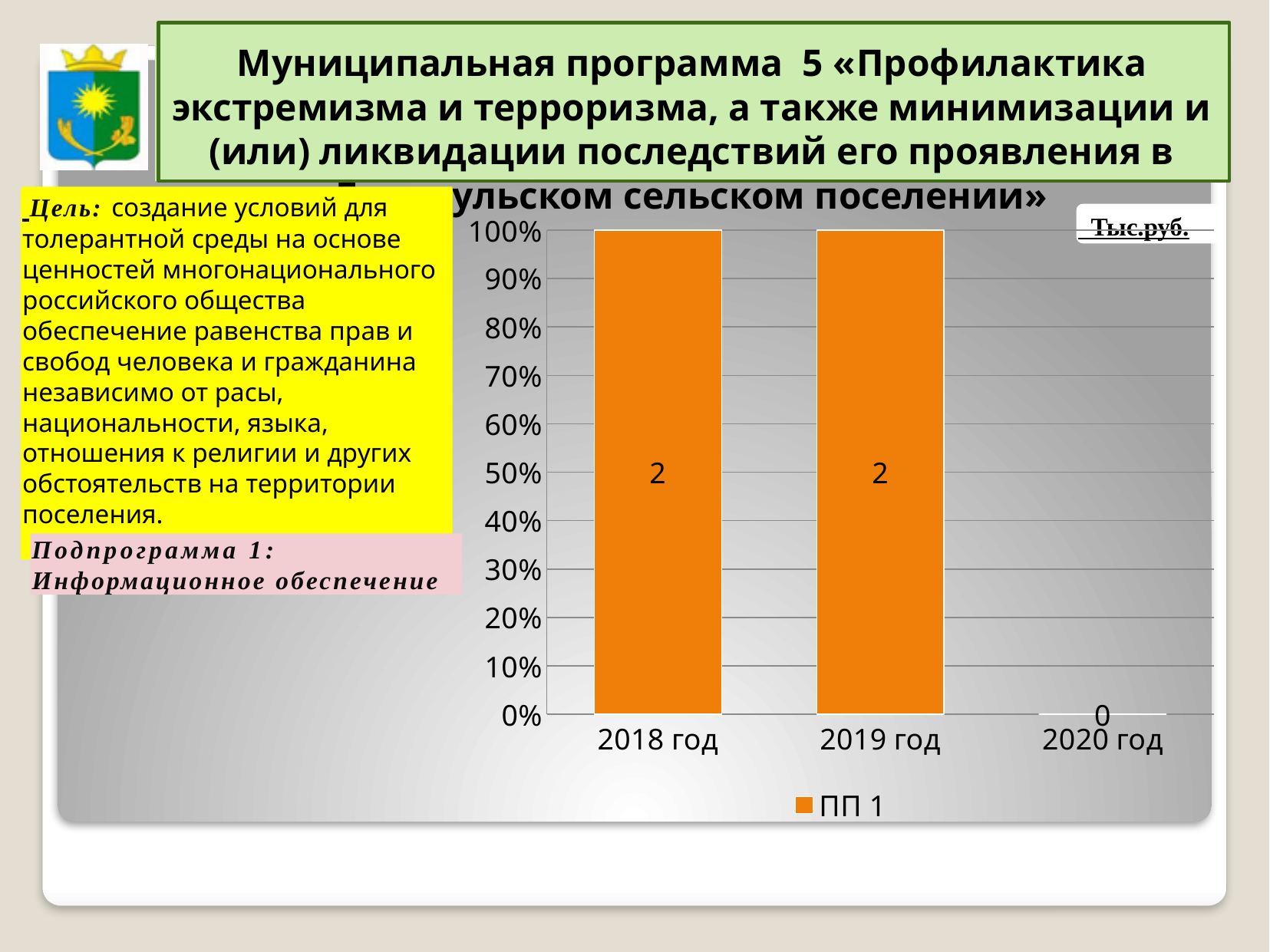
Is the value for 2019 год larger than the value for 2020 год? Yes What is the data label on the bar for 2019 год? 2 What is the data label on the bar for 2018 год? 2 What is the name of the series in the chart legend? ПП 1 What is the highest tick value shown on the y axis of the chart? 100% What value is shown for 2020 год? 0 What type of chart is shown on the slide? Bar chart What unit is indicated in the top right corner of the chart? Тыс.руб. Which year has the lowest value in the chart? 2020 год What is the difference between the values for 2018 год and 2020 год? 2 How many year categories are shown on the x axis of the chart? 3 How many series does the chart legend list? 1